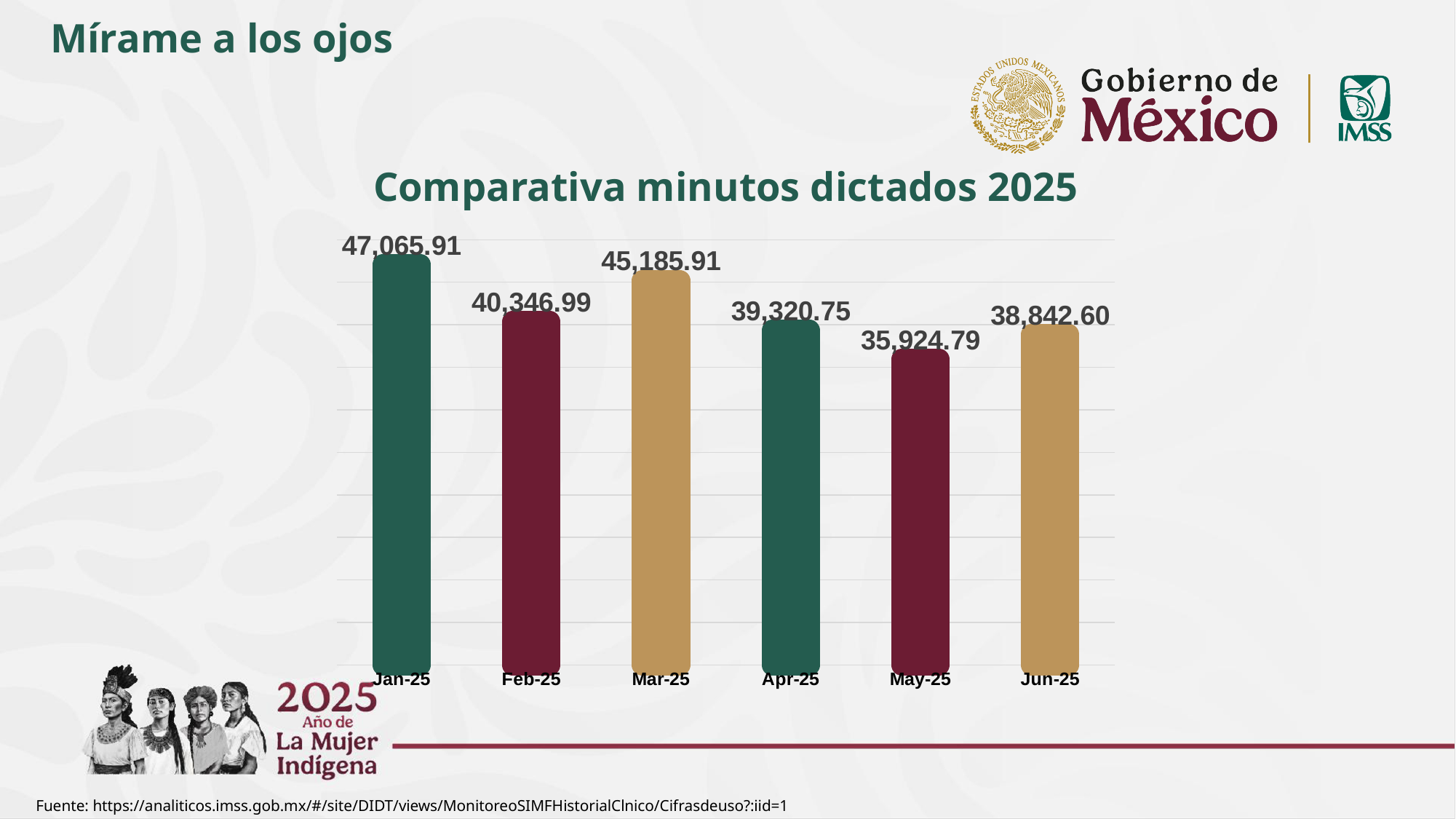
What is the title of the chart? Comparativa minutos dictados 2025 Which is larger, the value for Feb-25 or the value for Apr-25? Feb-25 What is the difference between the values for Jan-25 and Feb-25? 6,718.92 How many months are shown in the chart? 6 What is the value for May-25 in the chart? 35,924.79 What is the value for Jun-25 in the chart? 38,842.60 Which month has the highest value in the chart? Jan-25 What is the difference between the values for Jun-25 and May-25? 2,917.81 What is the value for Jan-25 in the chart? 47,065.91 What is the value for Mar-25 in the chart? 45,185.91 What kind of chart is shown on the slide? Bar chart Which month has the lowest value in the chart? May-25